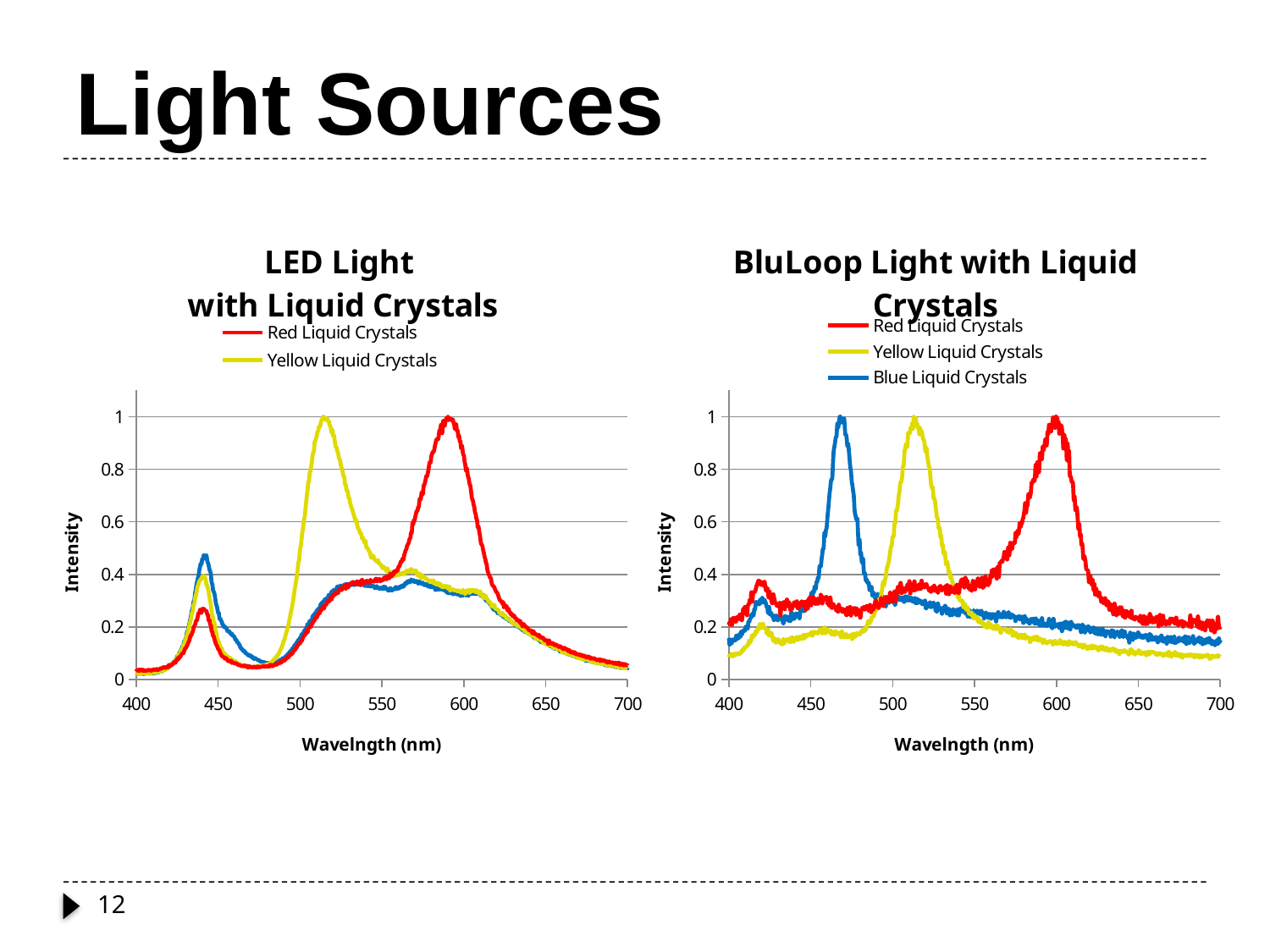
How many series does the legend of the 'BluLoop Light with Liquid Crystals' chart list? 3 In the 'BluLoop Light with Liquid Crystals' chart, is the peak intensity of the Blue Liquid Crystals series near 470 nm greater or less than 0.8? greater In the 'LED Light with Liquid Crystals' chart, is the peak intensity of the Red Liquid Crystals series near 590 nm greater or less than 0.8? greater In the 'BluLoop Light with Liquid Crystals' chart, which series has the higher intensity at 600 nm, Red Liquid Crystals or Blue Liquid Crystals? Red Liquid Crystals What is the x-axis title of the 'LED Light with Liquid Crystals' chart? Wavelngth (nm) In the 'BluLoop Light with Liquid Crystals' chart, does the Red Liquid Crystals series rise or fall between 600 nm and 650 nm? fall In the 'LED Light with Liquid Crystals' chart, which series has the higher intensity at 500 nm, Yellow Liquid Crystals or Red Liquid Crystals? Yellow Liquid Crystals In the 'LED Light with Liquid Crystals' chart, is the intensity of the Red Liquid Crystals series at 450 nm greater or less than 0.4? less What kind of chart is the 'LED Light with Liquid Crystals' chart? line chart In the 'BluLoop Light with Liquid Crystals' chart, which series is listed third in the legend? Blue Liquid Crystals How many series does the legend of the 'LED Light with Liquid Crystals' chart list? 2